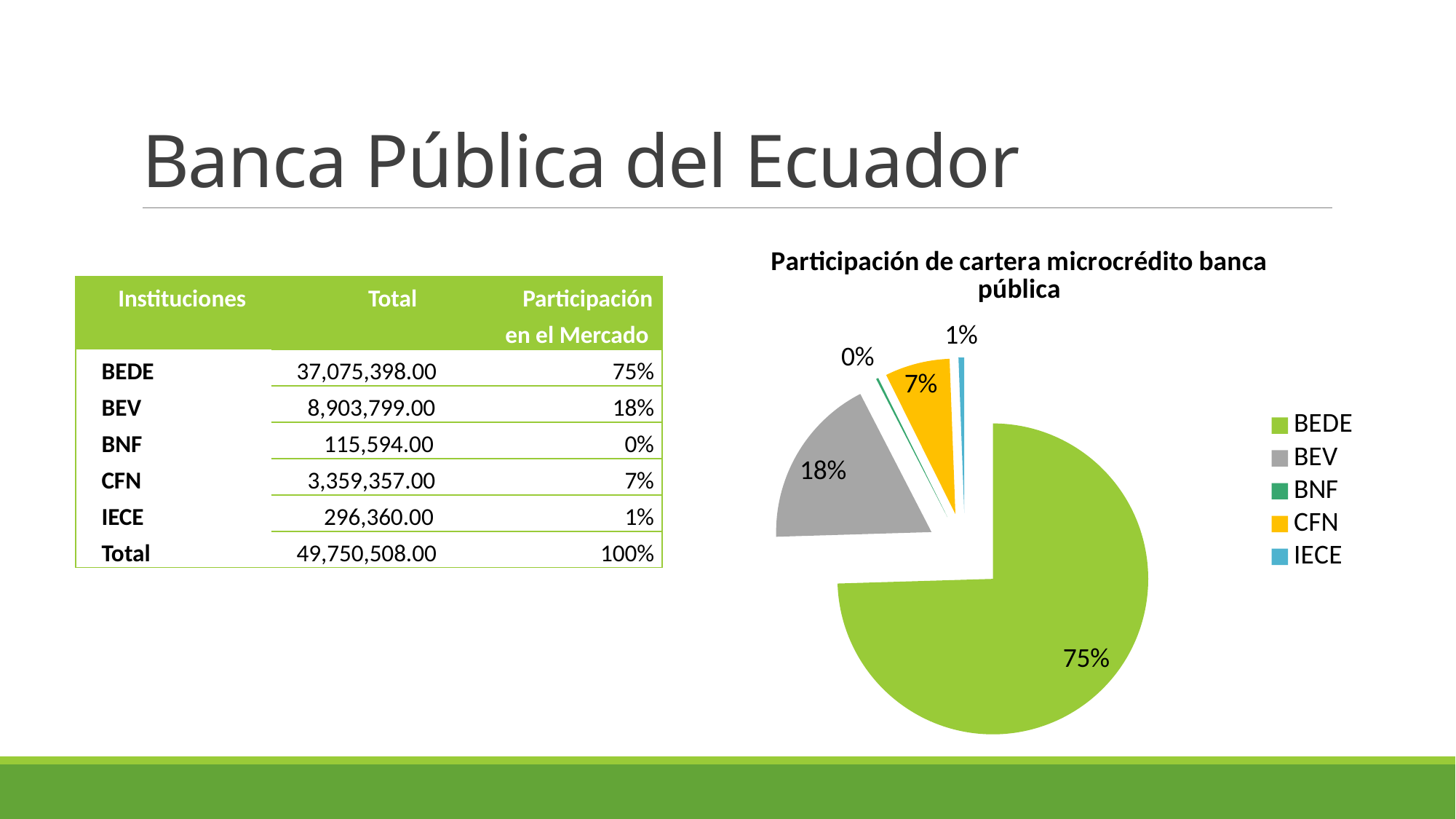
What share of the pie does IECE hold? 1% What share of the pie does BEDE hold? 75% What share of the pie does BEV hold? 18% What type of chart is shown on the slide? pie chart Which institution has the smallest slice of the pie? BNF Which institution has the largest slice of the pie? BEDE What is the title of the chart? Participación de cartera microcrédito banca pública What is the difference in percentage points between the BEDE slice and the BEV slice? 57 What percentage is shown for BNF in the pie chart? 0% Which slice is larger, CFN or IECE? CFN How many entries does the chart legend list? 5